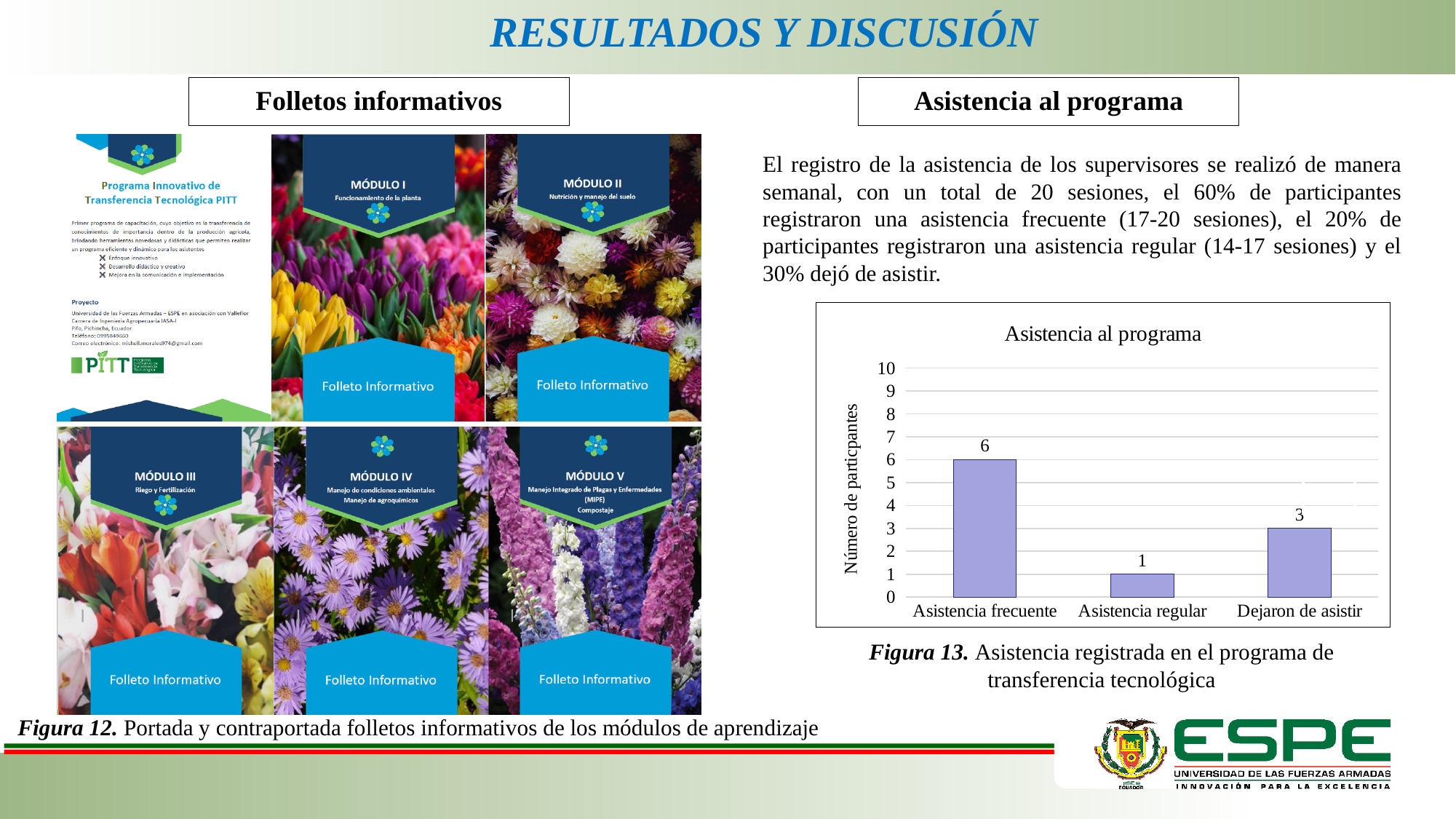
Which is larger, Asistencia regular or Dejaron de asistir? Dejaron de asistir What is the difference between Dejaron de asistir and Asistencia regular? 2 What is the value for Dejaron de asistir? 3 What is the difference between Asistencia frecuente and Dejaron de asistir? 3 What is the value for Asistencia frecuente? 6 What is the value for Asistencia regular? 1 What kind of chart is shown? bar chart Is the value for Asistencia frecuente greater or less than 5? greater What is the title of the chart? Asistencia al programa Which category has the highest value? Asistencia frecuente Which category has the lowest value? Asistencia regular How many categories are shown on the x axis of the chart? 3